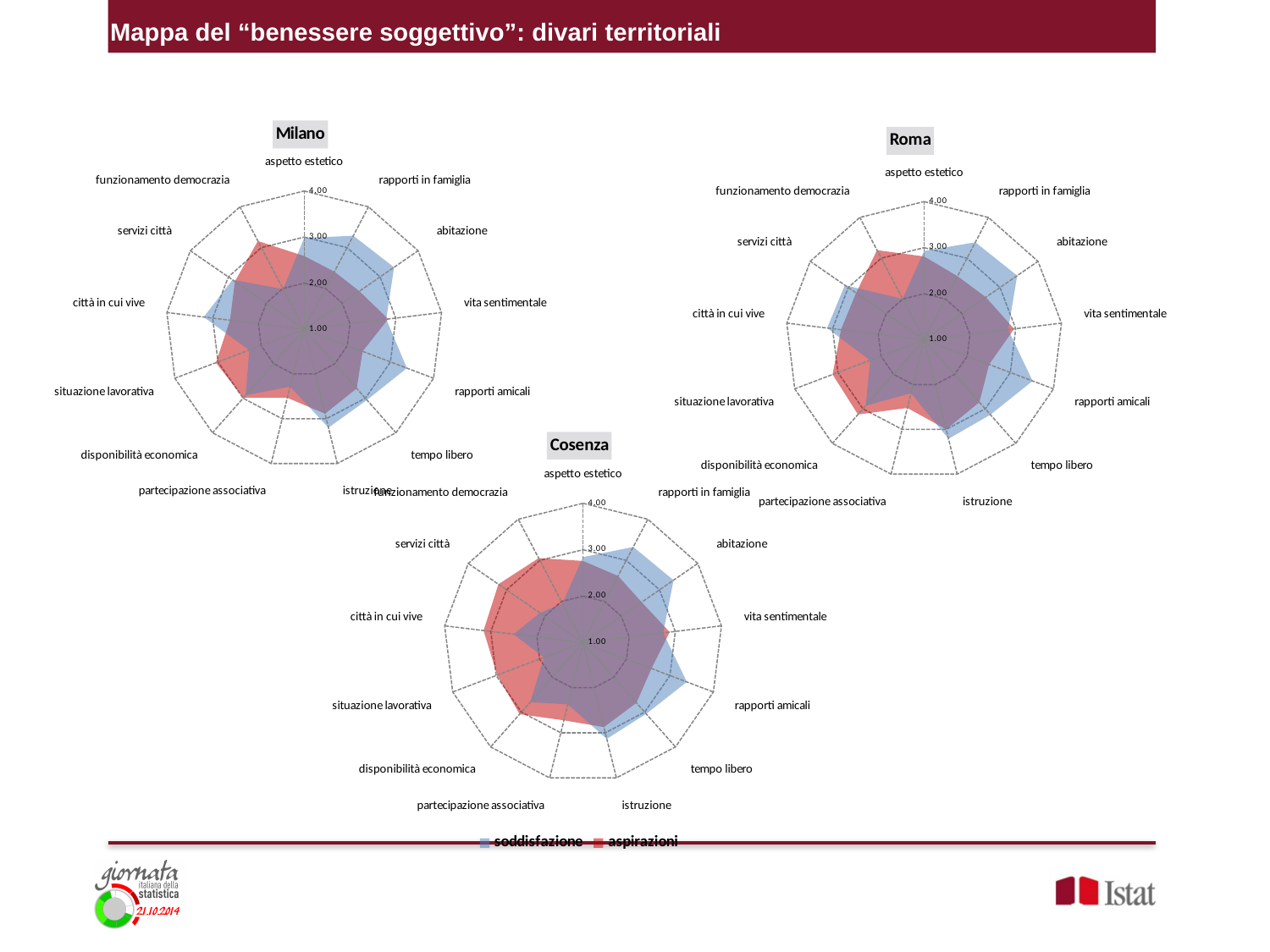
In the Milano chart, is the aspirazioni value for abitazione greater or less than 3.00? less In the Milano chart, is the soddisfazione value for rapporti amicali greater or less than 3.00? greater In the Cosenza chart, which series has the larger value for città in cui vive, soddisfazione or aspirazioni? aspirazioni How many categories (axes) does the Cosenza radar chart have? 13 What kind of chart is used for the Milano chart? radar chart In the Milano chart, which series has the larger value for abitazione, soddisfazione or aspirazioni? soddisfazione In the Milano chart, is the soddisfazione value for abitazione greater or less than 3.00? greater Which city's chart is positioned at the bottom centre of the slide? Cosenza How many series does the legend at the bottom of the slide list? 2 In the Roma chart, which series has the larger value for servizi città, soddisfazione or aspirazioni? soddisfazione What are the two series named in the legend? soddisfazione and aspirazioni